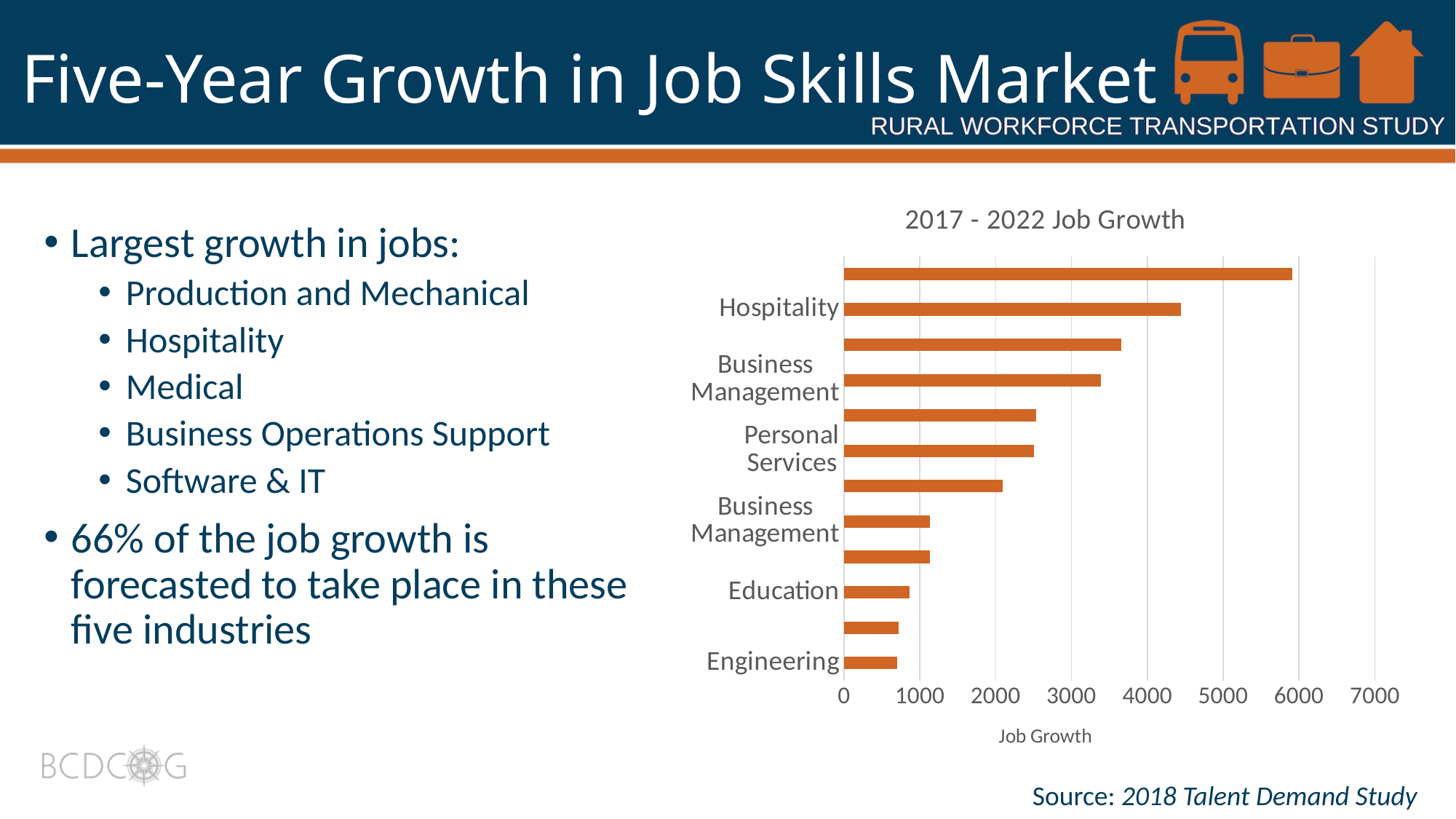
Is the value for Personal Services greater or less than 3000? less Do the bar values increase or decrease going from the top of the chart to the bottom? decrease What is the highest value shown on the horizontal axis? 7000 Which has the larger value, Education or Hospitality? Hospitality What kind of chart is shown on the slide? bar chart Is the value for Engineering greater or less than 1000? less Is the value for Hospitality greater or less than 4000? greater How many bars are plotted in the chart? 12 Which has the larger value, Hospitality or Personal Services? Hospitality What is the label on the horizontal axis of the chart? Job Growth What is the title of the chart? 2017 - 2022 Job Growth